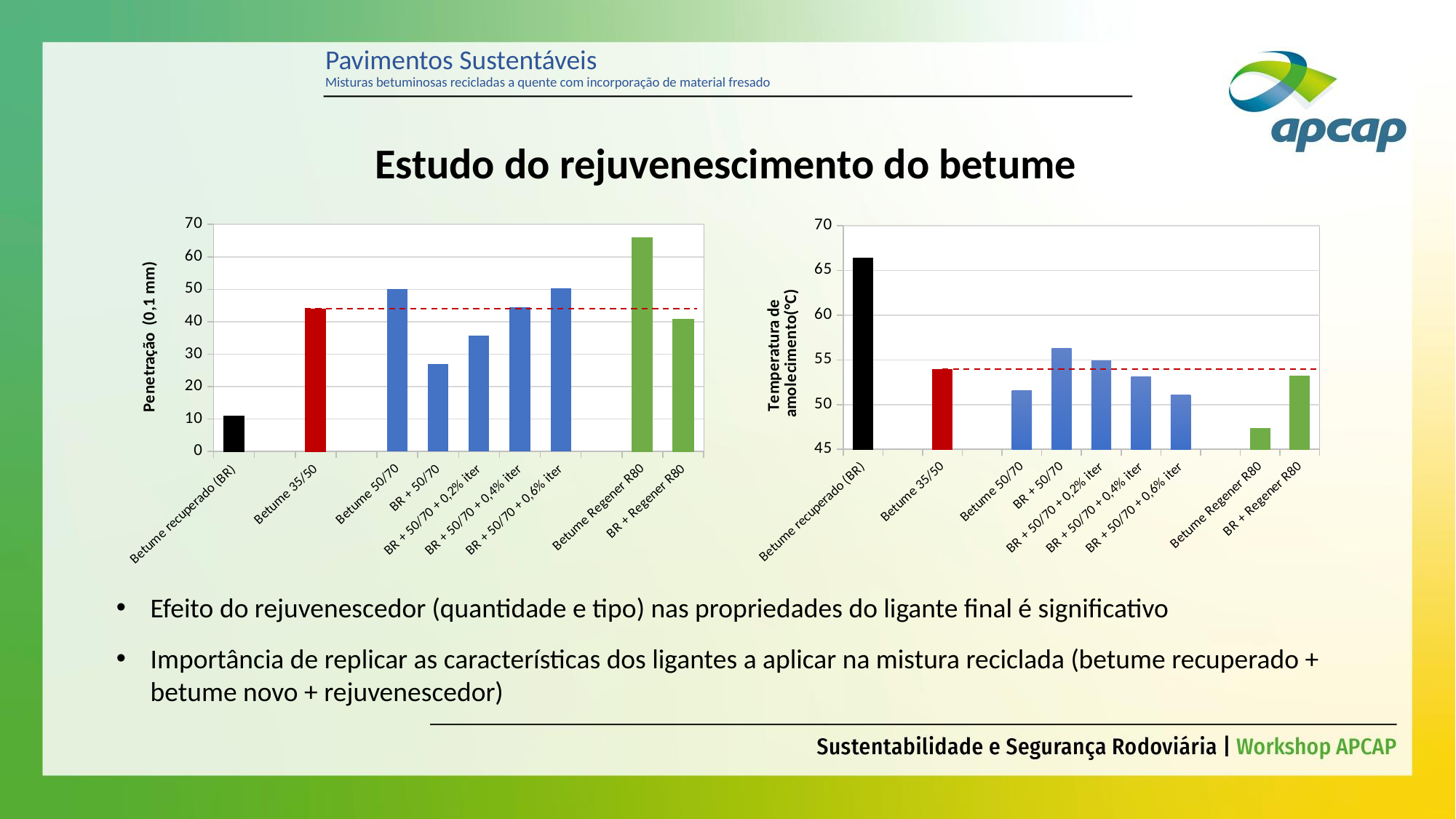
What kind of chart is the left chart (Penetração)? bar chart In the right chart (Temperatura de amolecimento), which category has the lowest value? Betume Regener R80 In the left chart (Penetração), is the value for BR + 50/70 greater or less than 30? less In the left chart (Penetração), which category has the lowest value? Betume recuperado (BR) How many categories are shown on the x axis of the left chart (Penetração)? 9 In the left chart (Penetração), which category has the highest value? Betume Regener R80 In the left chart (Penetração), is the value for Betume Regener R80 greater or less than 60? greater In the right chart (Temperatura de amolecimento), is the value for Betume recuperado (BR) greater or less than 65? greater In the left chart (Penetração), which is larger: Betume 50/70 or BR + 50/70 + 0,2% iter? Betume 50/70 In the right chart (Temperatura de amolecimento), which category has the highest value? Betume recuperado (BR) What is the y-axis label of the left chart? Penetração (0,1 mm)